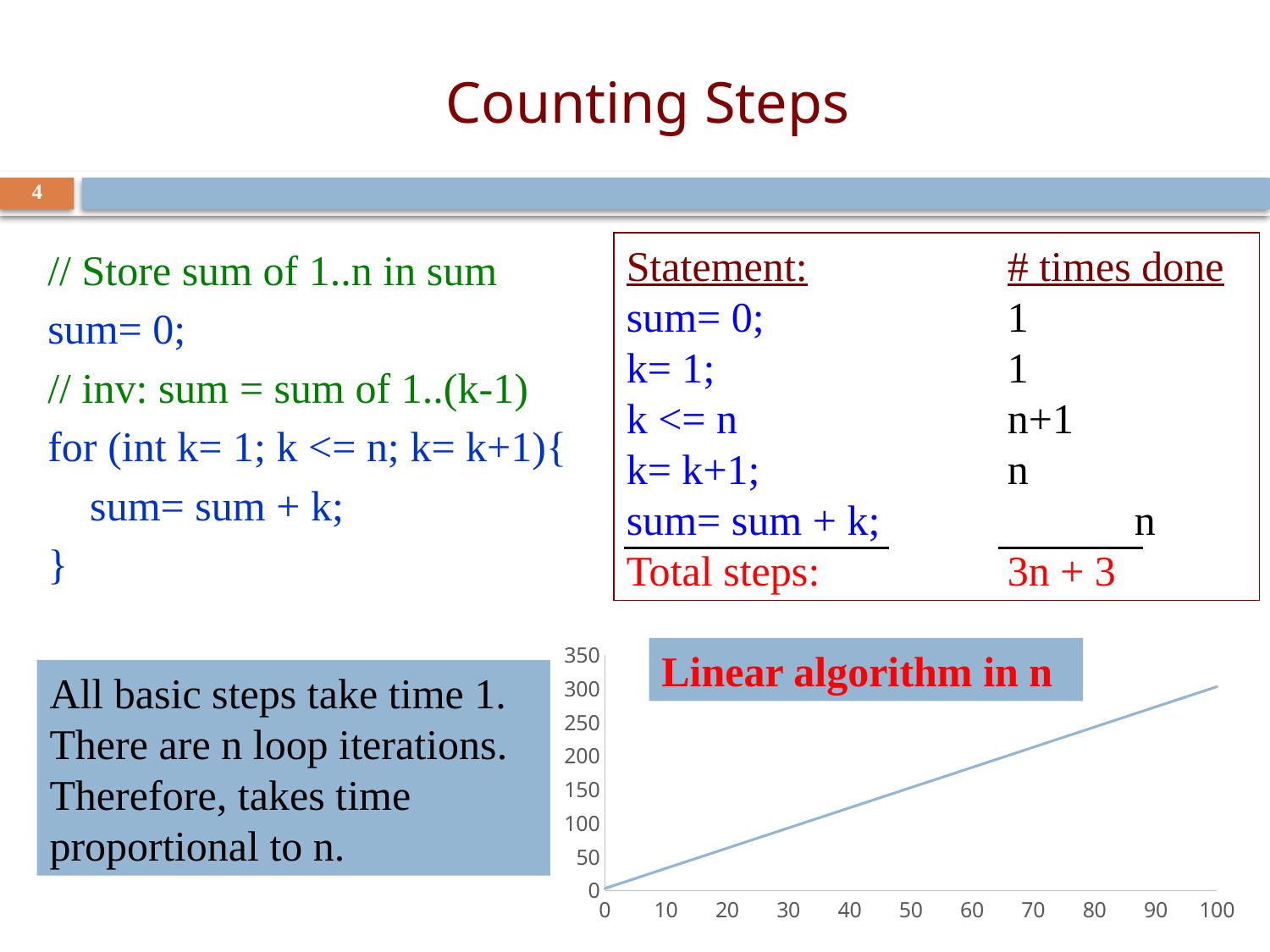
In the line chart at the bottom right, is the value at x = 100 greater or less than 250? greater In the line chart at the bottom right, is the value at x = 0 greater or less than 50? less In the line chart at the bottom right, is the value at x = 50 greater or less than 200? less What is the highest tick value shown on the x axis of the line chart at the bottom right? 100 What kind of chart is shown at the bottom right of the slide? line chart What is the highest tick value shown on the y axis of the line chart at the bottom right? 350 In the line chart at the bottom right, do the values rise or fall as the x axis increases from 0 to 100? rise